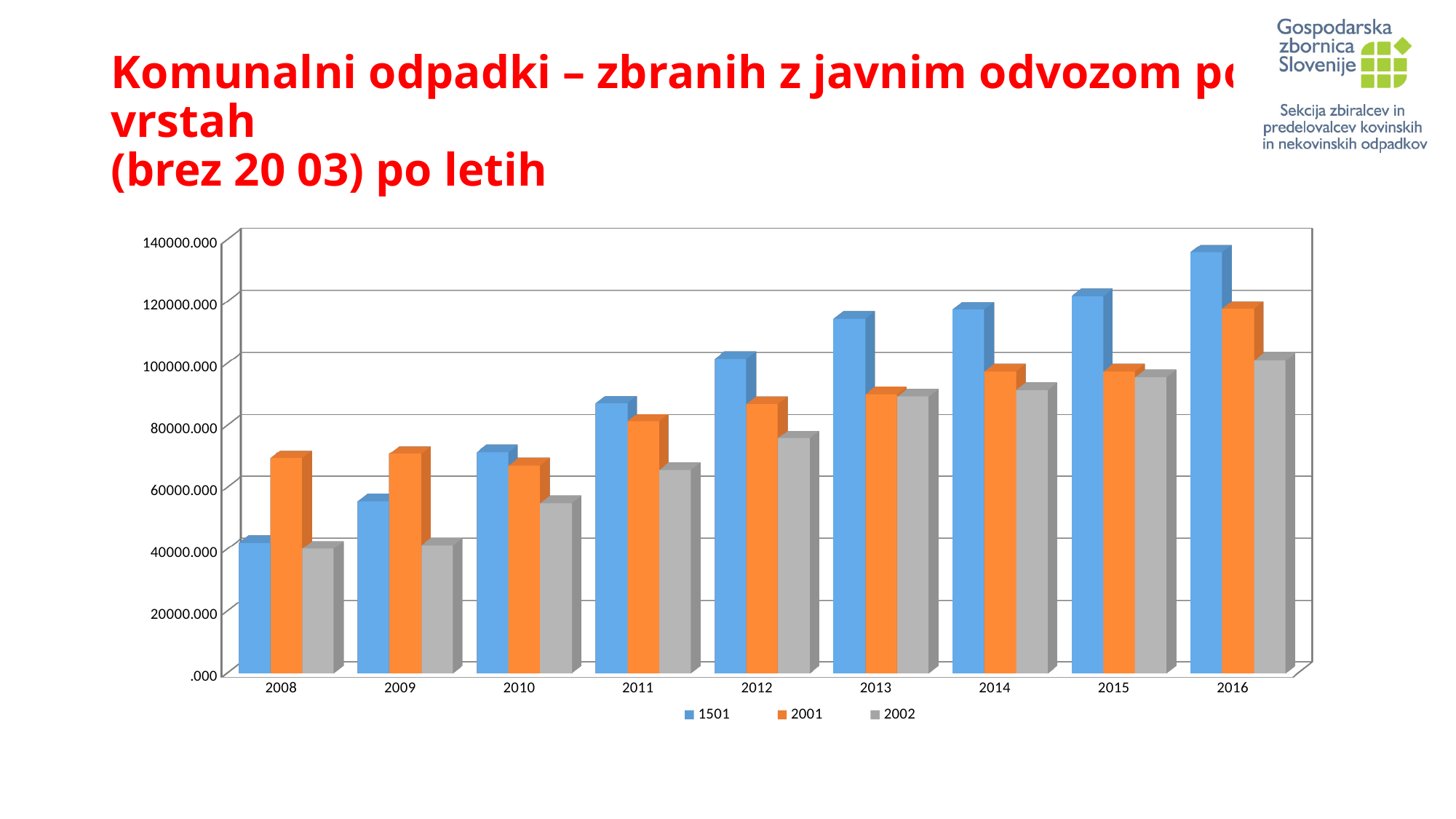
What colour are the bars for series 1501? blue In 2008, which series has the larger value, 1501 or 2001? 2001 In which year is the value for series 1501 highest? 2016 Which series are listed in the chart's legend? 1501, 2001, 2002 Do the values for series 1501 rise or fall from 2008 to 2016? rise What kind of chart is shown on the slide? bar chart Is the value for series 2002 in 2008 greater or less than 60000.000? less In which year is the value for series 1501 lowest? 2008 Is the value for series 1501 in 2016 greater or less than 120000.000? greater In which year is the value for series 2001 highest? 2016 How many years are shown on the x axis of the chart? 9 How many series does the chart's legend list? 3